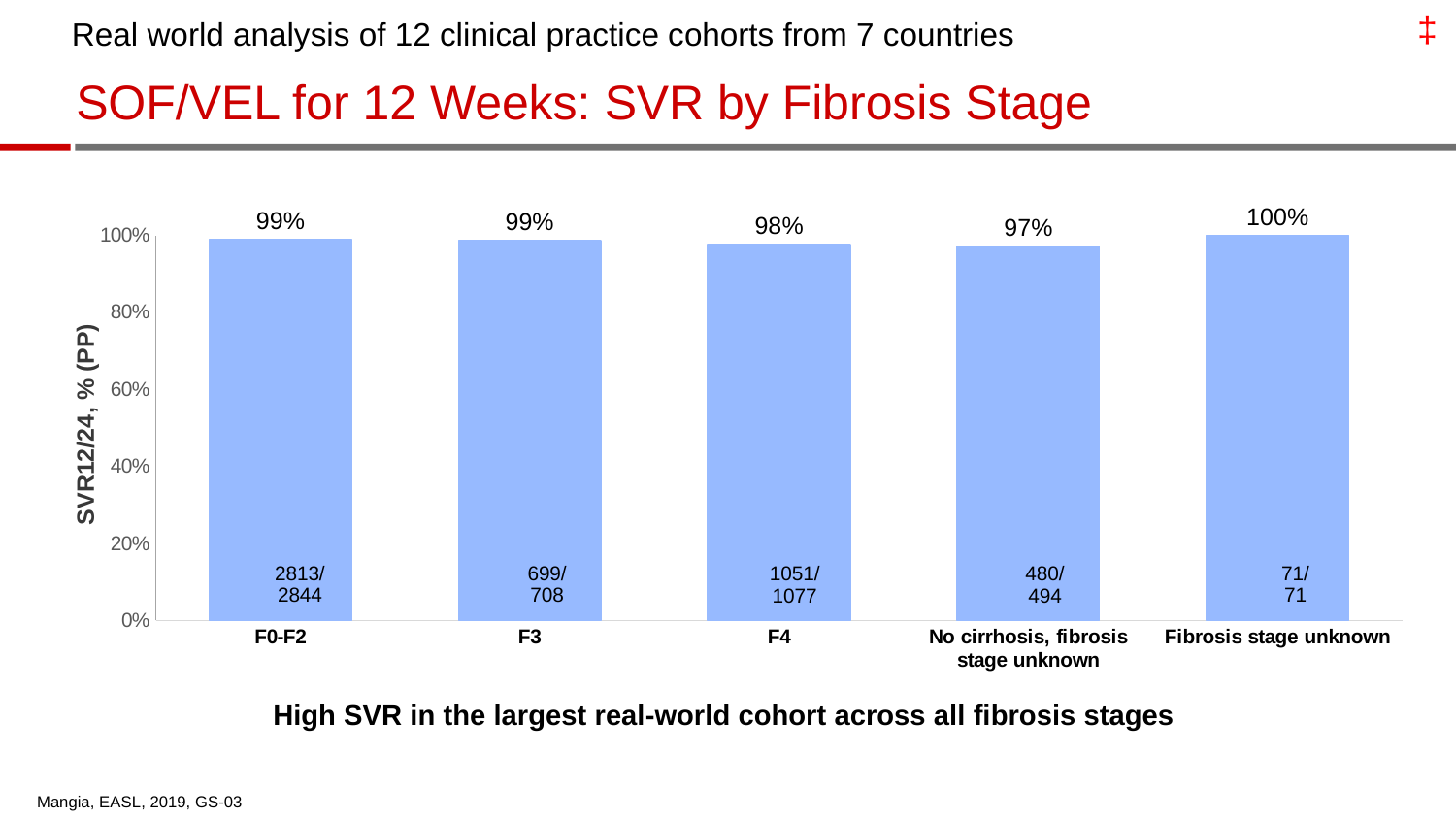
Which fibrosis stage category has the lowest SVR12/24 value? No cirrhosis, fibrosis stage unknown How many fibrosis stage categories are shown on the chart? 5 What is the SVR12/24 value for the F4 fibrosis stage? 98% What is the patient fraction shown inside the bar for the F3 category? 699/708 What is the patient fraction shown inside the bar for the 'Fibrosis stage unknown' category? 71/71 What is the SVR12/24 value for the F0-F2 fibrosis stage? 99% Which fibrosis stage category has the highest SVR12/24 value? Fibrosis stage unknown What is the difference in SVR12/24 between the 'Fibrosis stage unknown' and 'No cirrhosis, fibrosis stage unknown' categories? 3% Which has a higher SVR12/24 value, F3 or F4? F3 What is the label of the y-axis on the chart? SVR12/24, % (PP) What is the SVR12/24 value for the 'No cirrhosis, fibrosis stage unknown' category? 97% What kind of chart is shown on the slide? Bar chart